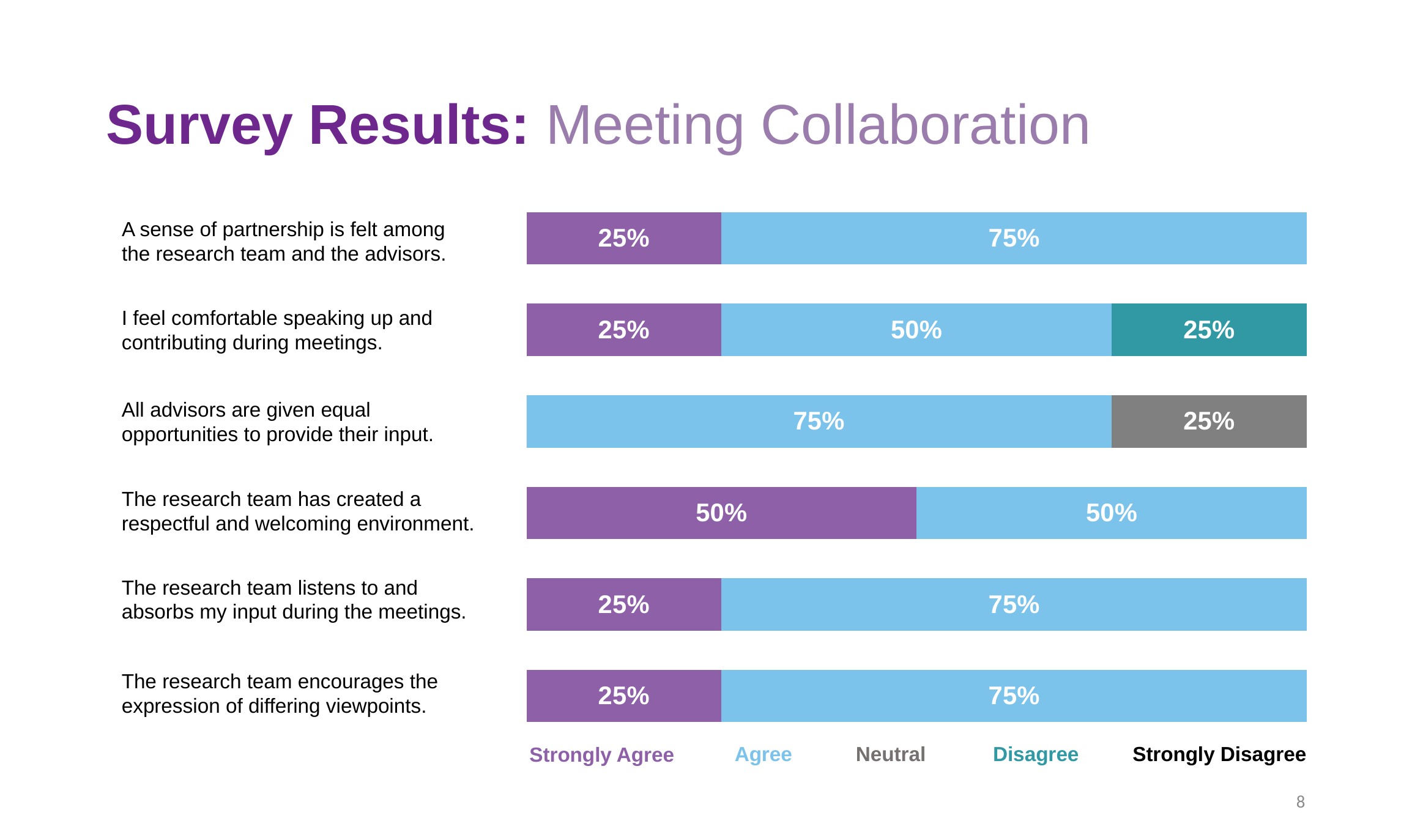
For "The research team encourages the expression of differing viewpoints", which is larger: the Agree share or the Strongly Agree share? Agree How many statements (categories) are plotted in the chart? 6 What percentage of respondents answered Neutral to "All advisors are given equal opportunities to provide their input"? 25% What kind of chart is shown on the slide? Stacked bar chart Which statement has the highest Strongly Agree percentage? The research team has created a respectful and welcoming environment. How many response categories does the legend list? 5 Which colour represents the Disagree response in the chart? Teal What percentage of respondents answered Strongly Agree to "The research team has created a respectful and welcoming environment"? 50% What is the difference between the Agree and Strongly Agree percentages for "The research team listens to and absorbs my input during the meetings"? 50% What percentage of respondents answered Agree to "I feel comfortable speaking up and contributing during meetings"? 50% What percentage of respondents answered Strongly Agree to "A sense of partnership is felt among the research team and the advisors"? 25% What percentage of respondents answered Disagree to "I feel comfortable speaking up and contributing during meetings"? 25%